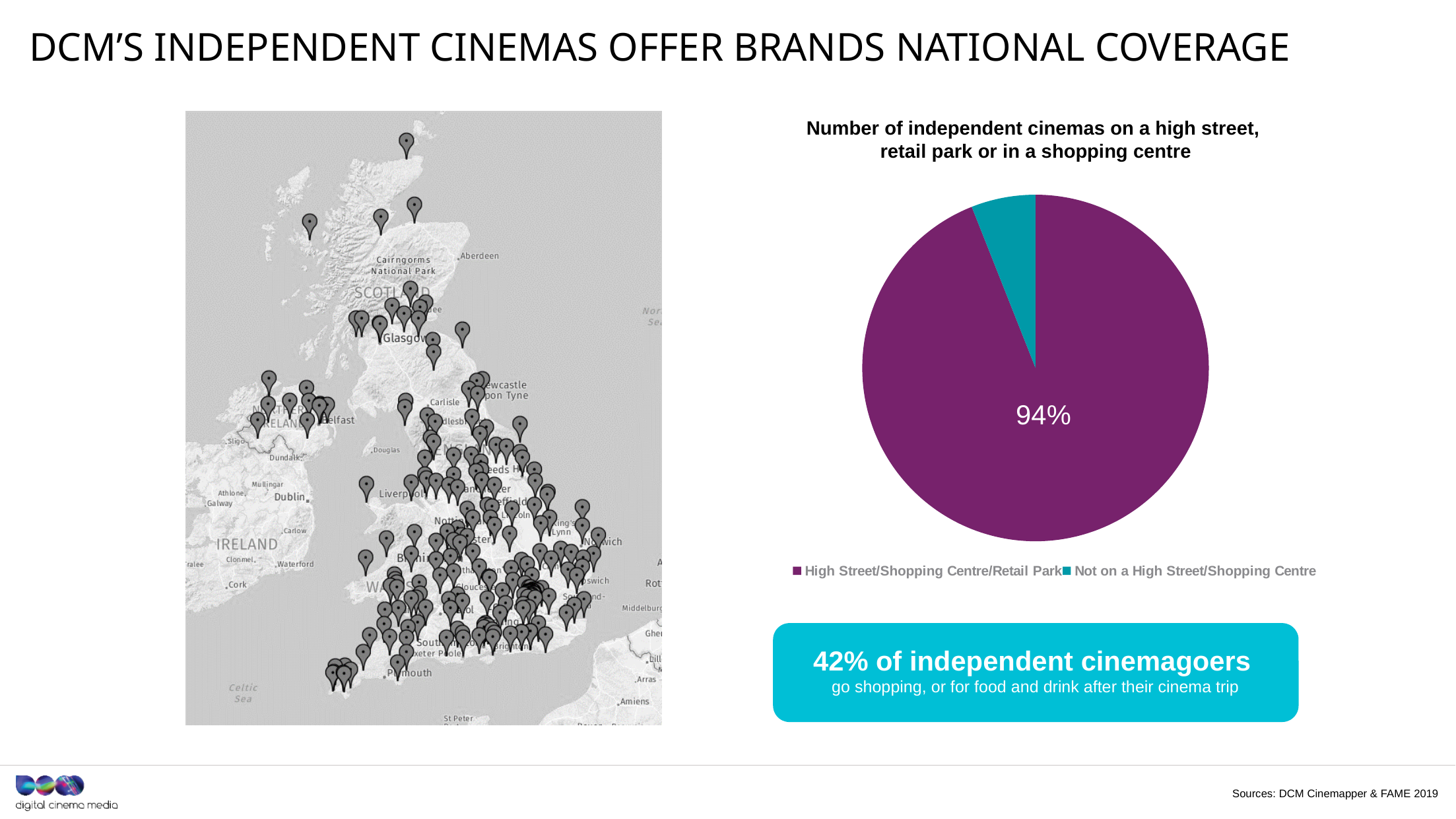
What is the title of the pie chart? Number of independent cinemas on a high street, retail park or in a shopping centre What percentage value is printed inside the pie chart? 94% What share of the pie does the High Street/Shopping Centre/Retail Park slice represent? 94% How many slices does the pie chart have? 2 How many categories does the legend of the pie chart list? 2 Which category has the largest slice of the pie? High Street/Shopping Centre/Retail Park Which category has the smallest slice of the pie? Not on a High Street/Shopping Centre Which is larger: the High Street/Shopping Centre/Retail Park slice or the Not on a High Street/Shopping Centre slice? High Street/Shopping Centre/Retail Park What kind of chart is shown on the slide? pie chart What colour is the Not on a High Street/Shopping Centre slice in the pie chart? teal